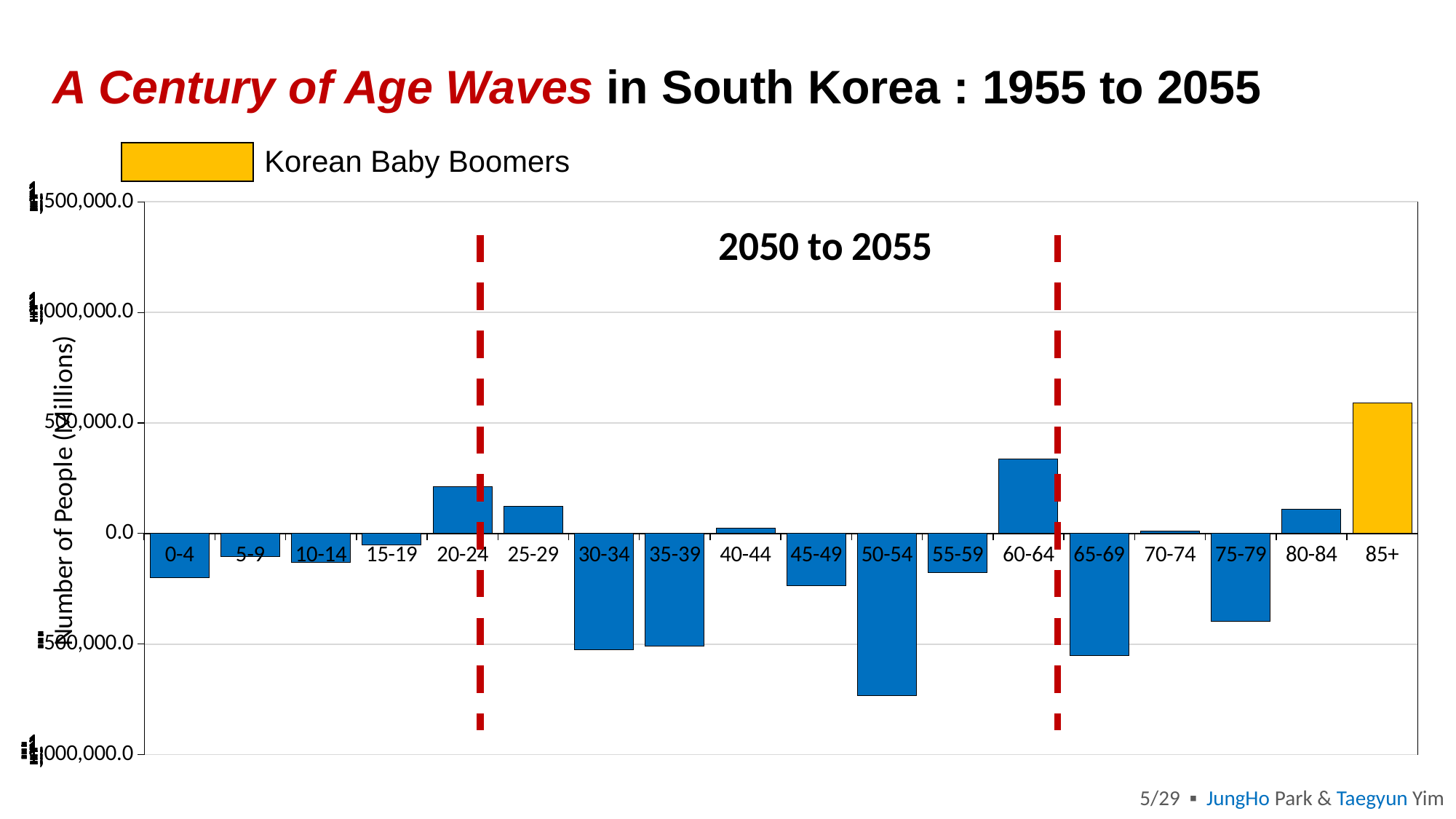
Which has the larger value, 60-64 or 20-24? 60-64 Which age group has the lowest value? 50-54 Is the value for 50-54 greater or less than -500,000.0? less Is the value for 85+ greater or less than 500,000.0? greater Is the value for 60-64 greater or less than 500,000.0? less What period does the chart's title say the data covers? 2050 to 2055 Which has the larger value, 85+ or 60-64? 85+ What does the yellow bar colour represent according to the legend? Korean Baby Boomers How many age-group categories are plotted on the x axis? 18 Which age group has the highest value? 85+ What kind of chart is shown on the slide? bar chart